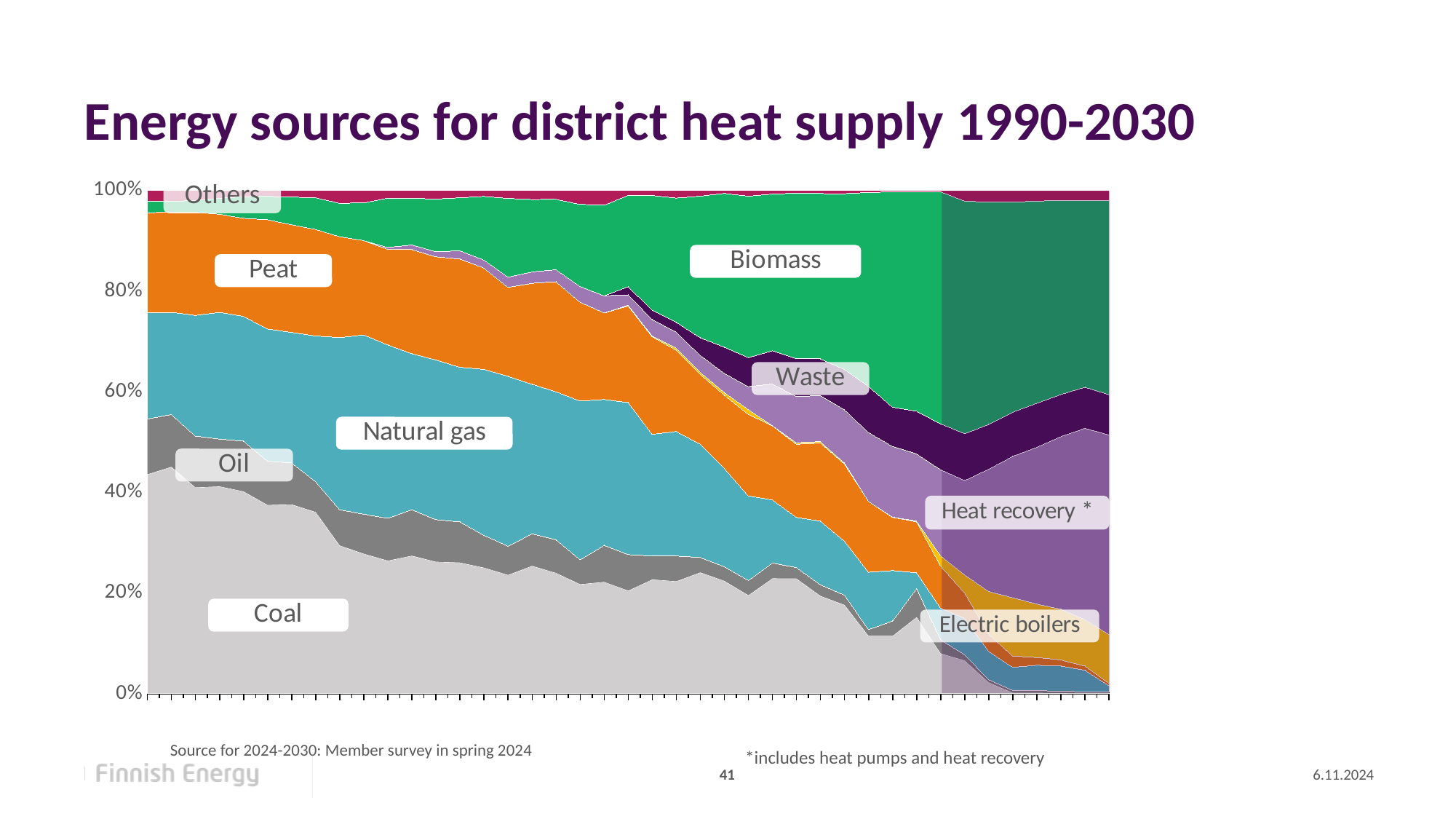
At the end of the period (2030), is the share of Coal greater or less than 20%? less Does the share of Natural gas rise or fall over the period shown? Fall How many energy source series are labelled on the chart? 9 What is the highest value shown on the vertical axis? 100% Which energy source is plotted at the bottom of the stacked area chart? Coal At the end of the period (2030), which has the larger share: Heat recovery or Electric boilers? Heat recovery Does the share of Coal rise or fall from 1990 to 2030? Fall At the start of the period (1990), is the share of Coal greater or less than 40%? greater Does the share of Biomass rise or fall from 1990 to 2030? Rise At the end of the period (2030), is the share of Biomass greater or less than 20%? greater What kind of chart is shown on the slide? Stacked area chart What is the title of the chart? Energy sources for district heat supply 1990-2030